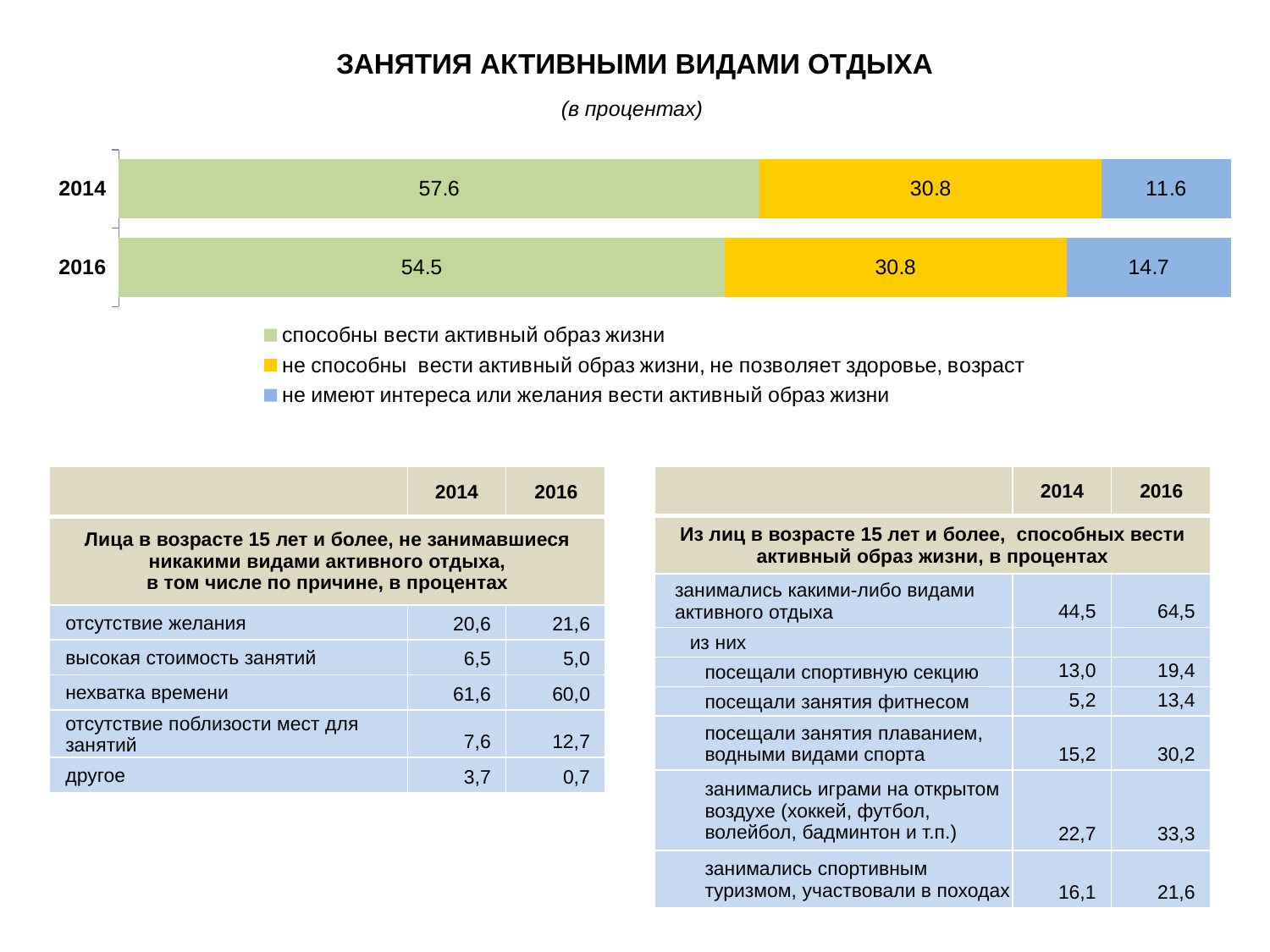
What is the value for "не способны вести активный образ жизни, не позволяет здоровье, возраст" in 2014? 30.8 What is the value for "способны вести активный образ жизни" in 2016? 54.5 Which year has the higher value for "способны вести активный образ жизни"? 2014 What is the value for "не имеют интереса или желания вести активный образ жизни" in 2016? 14.7 Which segment is the smallest in the 2014 bar? не имеют интереса или желания вести активный образ жизни What is the difference between the 2014 and 2016 values for "не имеют интереса или желания вести активный образ жизни"? 3.1 What is the value for "способны вести активный образ жизни" in 2014? 57.6 What kind of chart is shown on the slide? stacked bar chart What colour represents "не способны вести активный образ жизни, не позволяет здоровье, возраст" in the chart? yellow What is the difference between the 2014 and 2016 values for "способны вести активный образ жизни"? 3.1 How many years (categories) are shown in the chart? 2 How many series does the legend list? 3